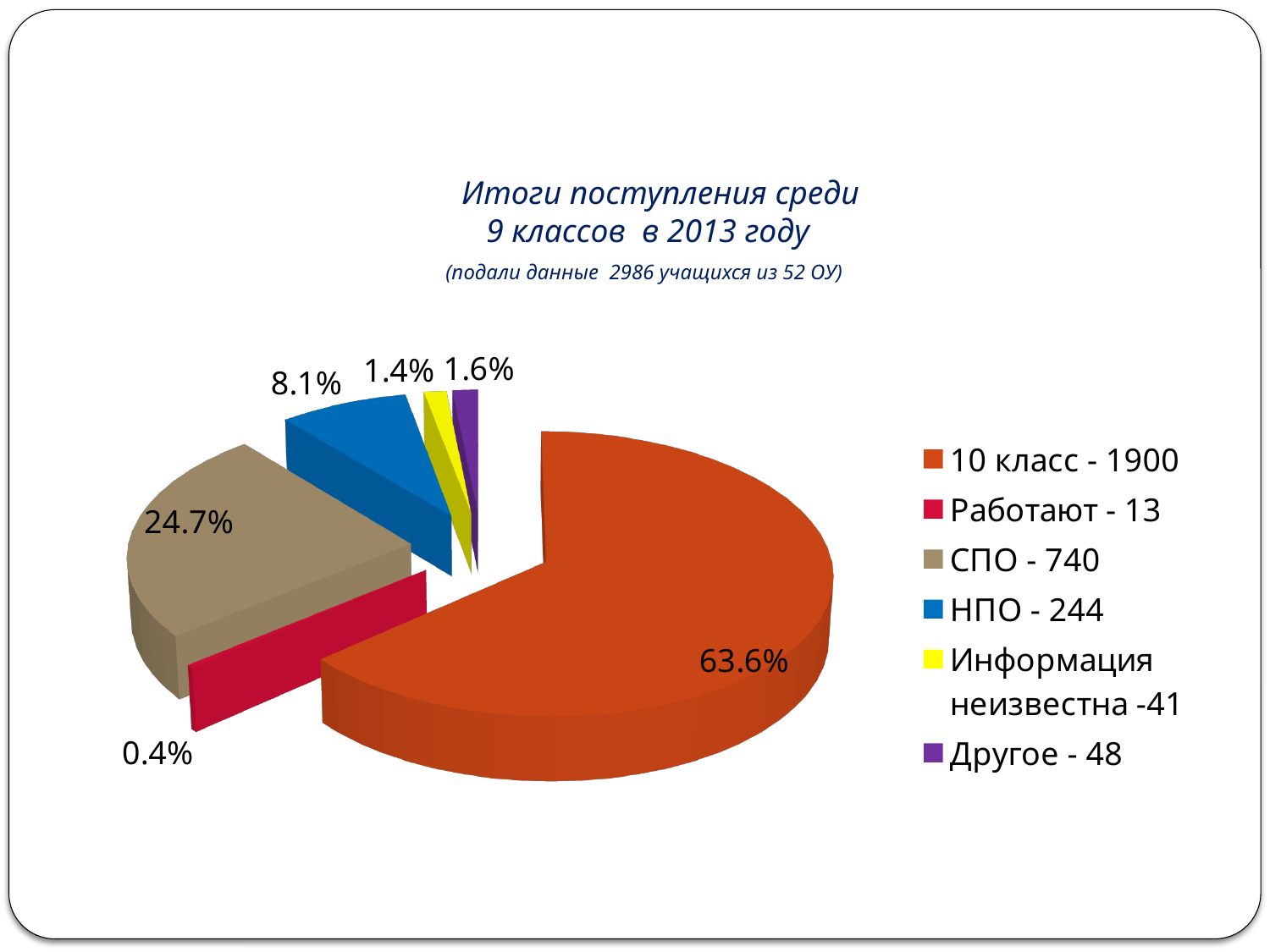
What kind of chart is shown on the slide? pie chart What share of the pie does the "СПО" slice represent? 24.7% Which slice is larger: "Другое" or "Информация неизвестна"? Другое What is the title of the chart? Итоги поступления среди 9 классов в 2013 году What percentage is shown for the "Работают" slice? 0.4% What is the difference in percentage points between the "10 класс" slice and the "СПО" slice? 38.9 Which category has the smallest slice of the pie? Работают What share of the pie does the "10 класс" slice represent? 63.6% How many slices does the pie chart have? 6 Which category has the largest slice of the pie? 10 класс According to the legend, how many students are in the "НПО" category? 244 What percentage is shown for the "НПО" slice? 8.1%